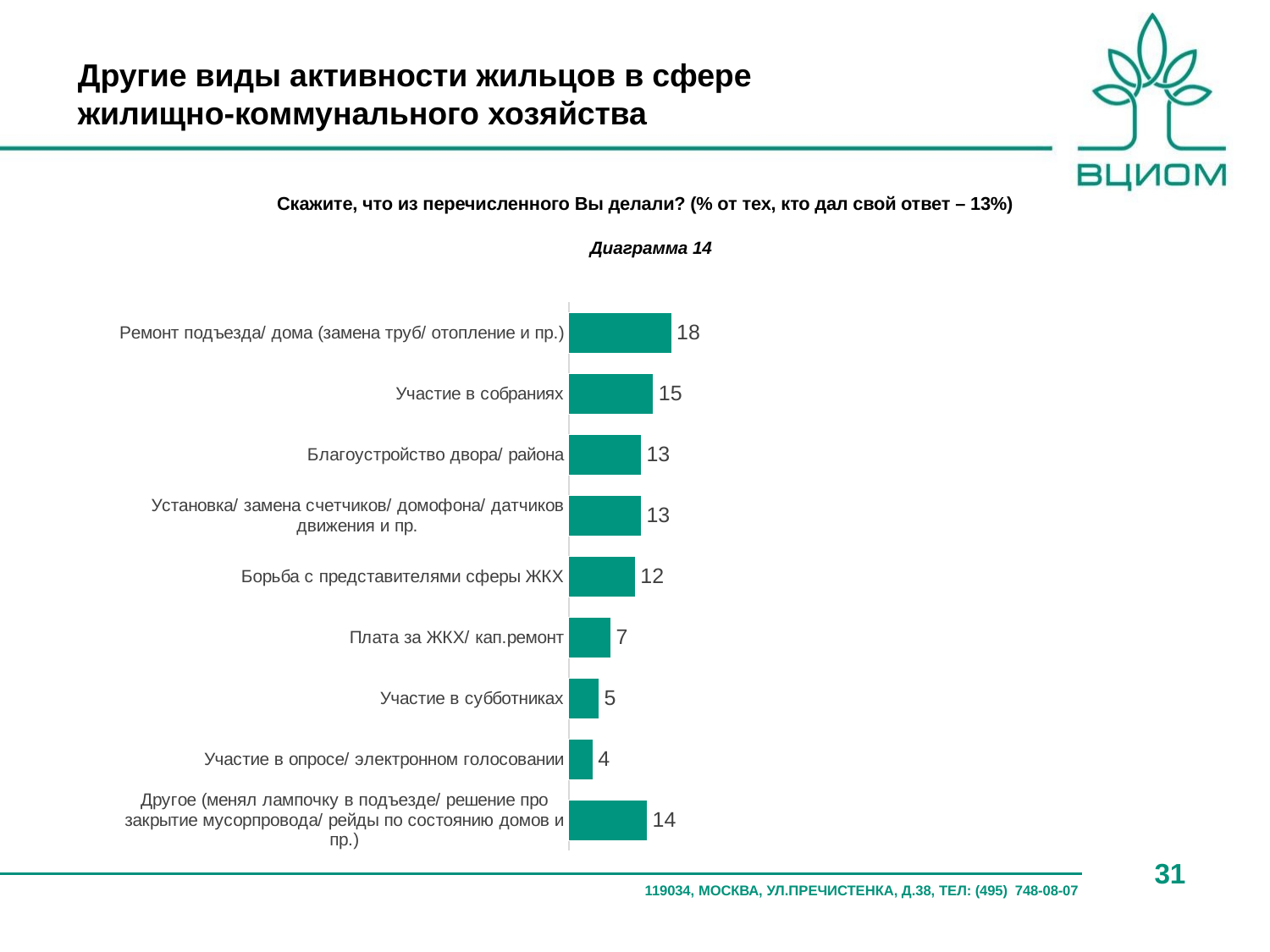
What is the value for "Плата за ЖКХ/ кап.ремонт"? 7 Which is larger: the value for "Участие в собраниях" or the value for "Другое (менял лампочку в подъезде/ решение про закрытие мусорпровода/ рейды по состоянию домов и пр.)"? Участие в собраниях What is the value for "Участие в собраниях"? 15 What kind of chart is shown on the slide? Bar chart What is the difference between the values for "Ремонт подъезда/ дома (замена труб/ отопление и пр.)" and "Участие в собраниях"? 3 What is the value for "Ремонт подъезда/ дома (замена труб/ отопление и пр.)"? 18 What is the value for "Другое (менял лампочку в подъезде/ решение про закрытие мусорпровода/ рейды по состоянию домов и пр.)"? 14 What is the title printed above the chart? Диаграмма 14 What is the difference between the values for "Борьба с представителями сферы ЖКХ" and "Участие в субботниках"? 7 How many categories are shown in the chart? 9 Which category has the highest value? Ремонт подъезда/ дома (замена труб/ отопление и пр.) Which category has the lowest value? Участие в опросе/ электронном голосовании